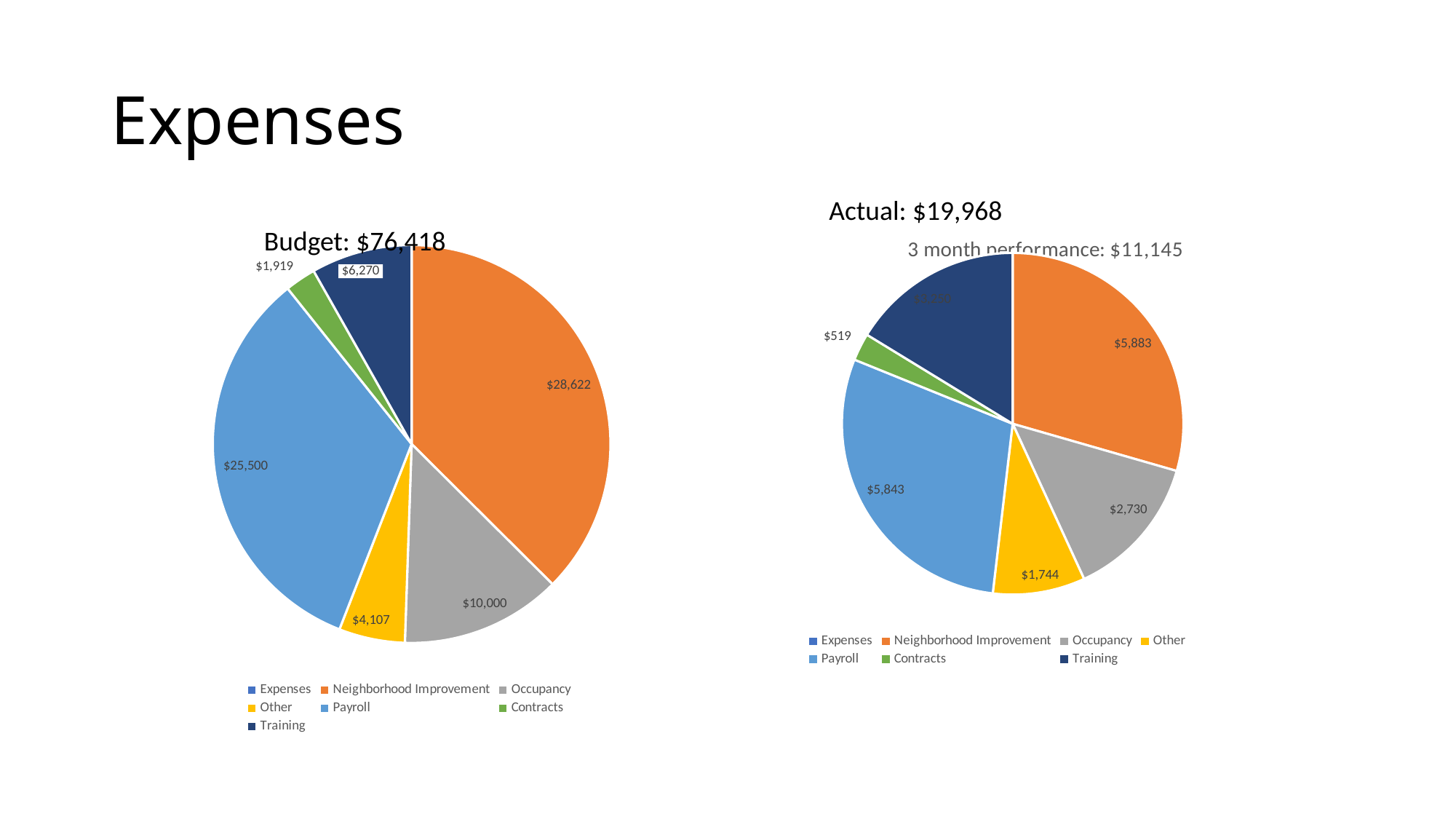
In the 3 month performance pie chart, what is the value for Contracts? $519 In the Budget pie chart, which category has the largest slice? Neighborhood Improvement How many entries does the legend of the Budget pie chart list? 7 In the Budget pie chart, which category has the smallest slice? Contracts In the Budget pie chart, what is the value for Occupancy? $10,000 In the Budget pie chart, what is the value for Neighborhood Improvement? $28,622 What type of chart is used on the left side of the slide? Pie chart In the 3 month performance pie chart, which is larger, Neighborhood Improvement or Payroll? Neighborhood Improvement In the 3 month performance pie chart, what is the difference between Occupancy and Other? $986 In the 3 month performance pie chart, what is the value for Occupancy? $2,730 In the Budget pie chart, what is the difference between Neighborhood Improvement and Payroll? $3,122 In the Budget pie chart, what is the value for Payroll? $25,500